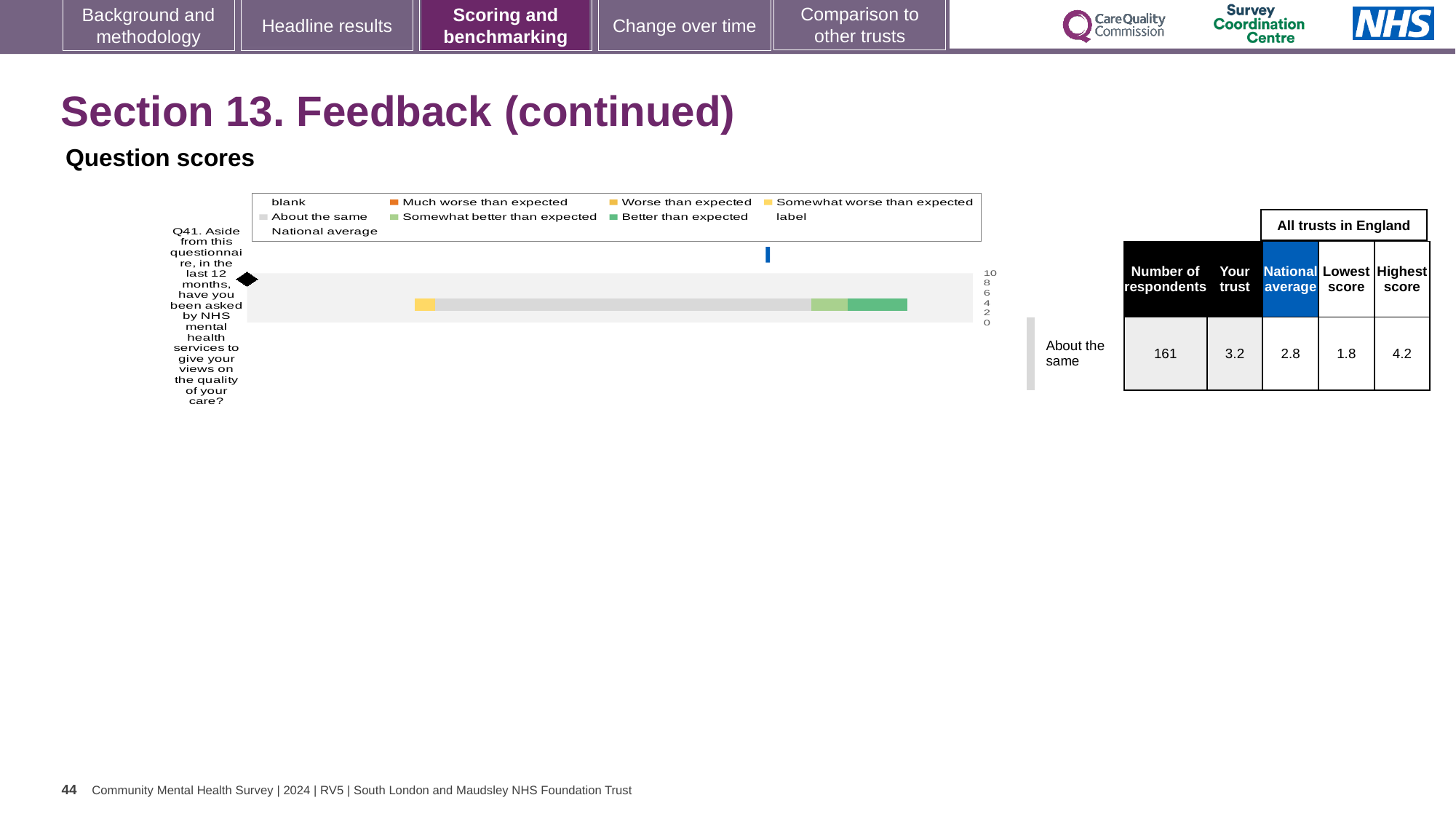
Which question is plotted in the bar chart? Q41. Aside from this questionnaire, in the last 12 months, have you been asked by NHS mental health services to give your views on the quality of your care? In the table next to the chart, what is the 'Your trust' score for Q41? 3.2 How many entries does the legend of the bar chart list? 9 What is the difference between the highest score (4.2) and the lowest score (1.8) for Q41? 2.4 Which is larger for Q41: the 'Your trust' score or the national average? Your trust What kind of chart is shown under 'Question scores'? bar chart In the table next to the chart, what is the highest score among all trusts in England for Q41? 4.2 How many questions (categories) are plotted in the bar chart? 1 In the table next to the chart, what is the lowest score among all trusts in England for Q41? 1.8 In the table next to the chart, what is the number of respondents for Q41? 161 In the table next to the chart, what is the national average score for Q41? 2.8 What colour is the 'Better than expected' segment in the bar chart legend? green